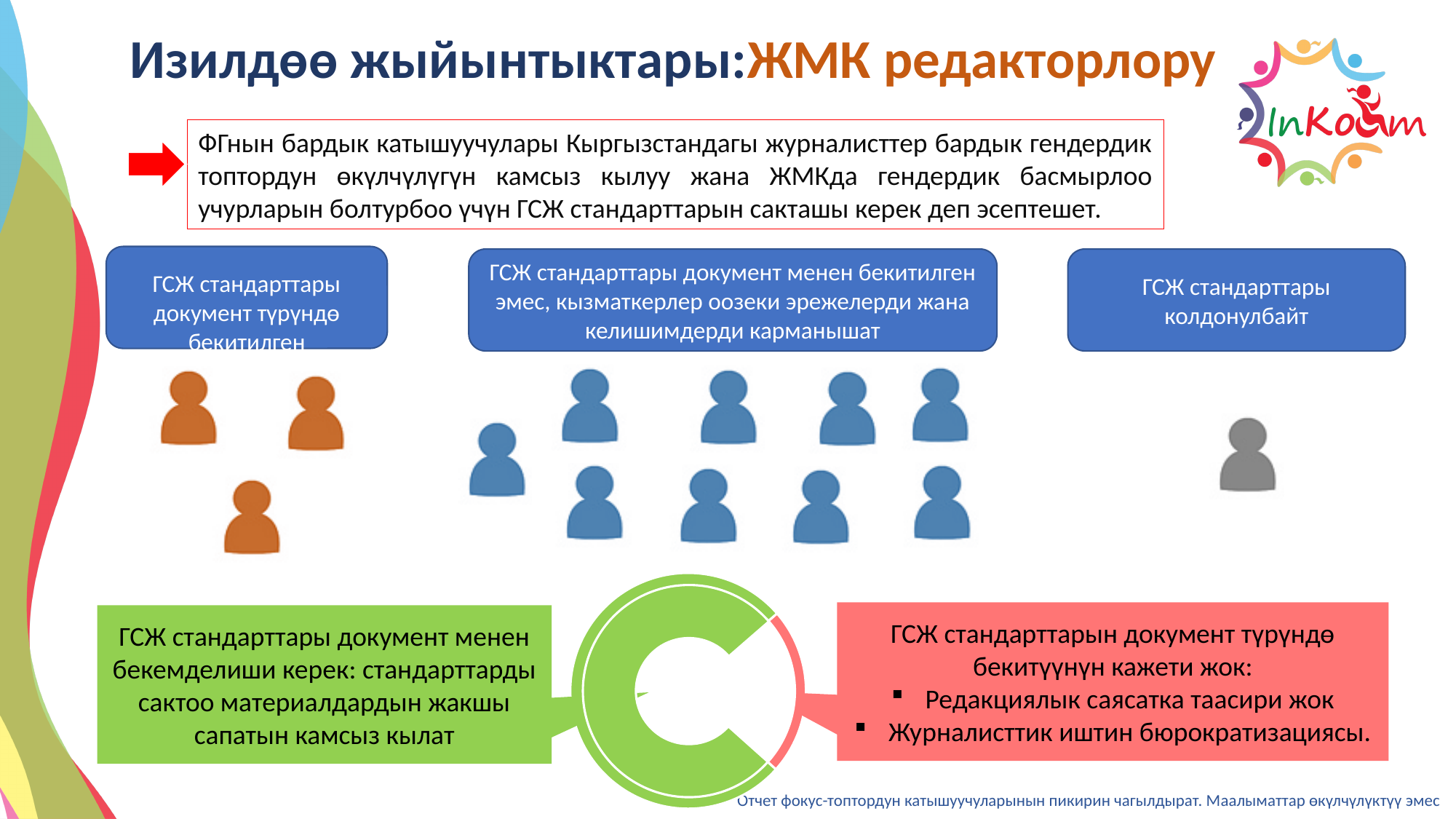
How many more person icons are in the middle category than in the "ГСЖ стандарттары документ түрүндө бекитилген" category? 6 Which category has the fewest person icons? ГСЖ стандарттары колдонулбайт How many person icons are shown under the category "ГСЖ стандарттары документ түрүндө бекитилген"? 3 How many person icons are shown under the category "ГСЖ стандарттары колдонулбайт"? 1 Which category has the most person icons? ГСЖ стандарттары документ менен бекитилген эмес, кызматкерлер оозеки эрежелерди жана келишимдерди карманышат What colour are the person icons for the category "ГСЖ стандарттары документ түрүндө бекитилген"? orange How many person icons are shown under the category "ГСЖ стандарттары документ менен бекитилген эмес, кызматкерлер оозеки эрежелерди жана келишимдерди карманышат"? 9 What is the total number of person icons across all three categories? 13 How many categories are shown in the person-icon graphic? 3 What colour are the person icons for the category "ГСЖ стандарттары колдонулбайт"? gray Which has more person icons: "ГСЖ стандарттары документ түрүндө бекитилген" or "ГСЖ стандарттары колдонулбайт"? ГСЖ стандарттары документ түрүндө бекитилген What kind of chart is the person-icon graphic? pictogram